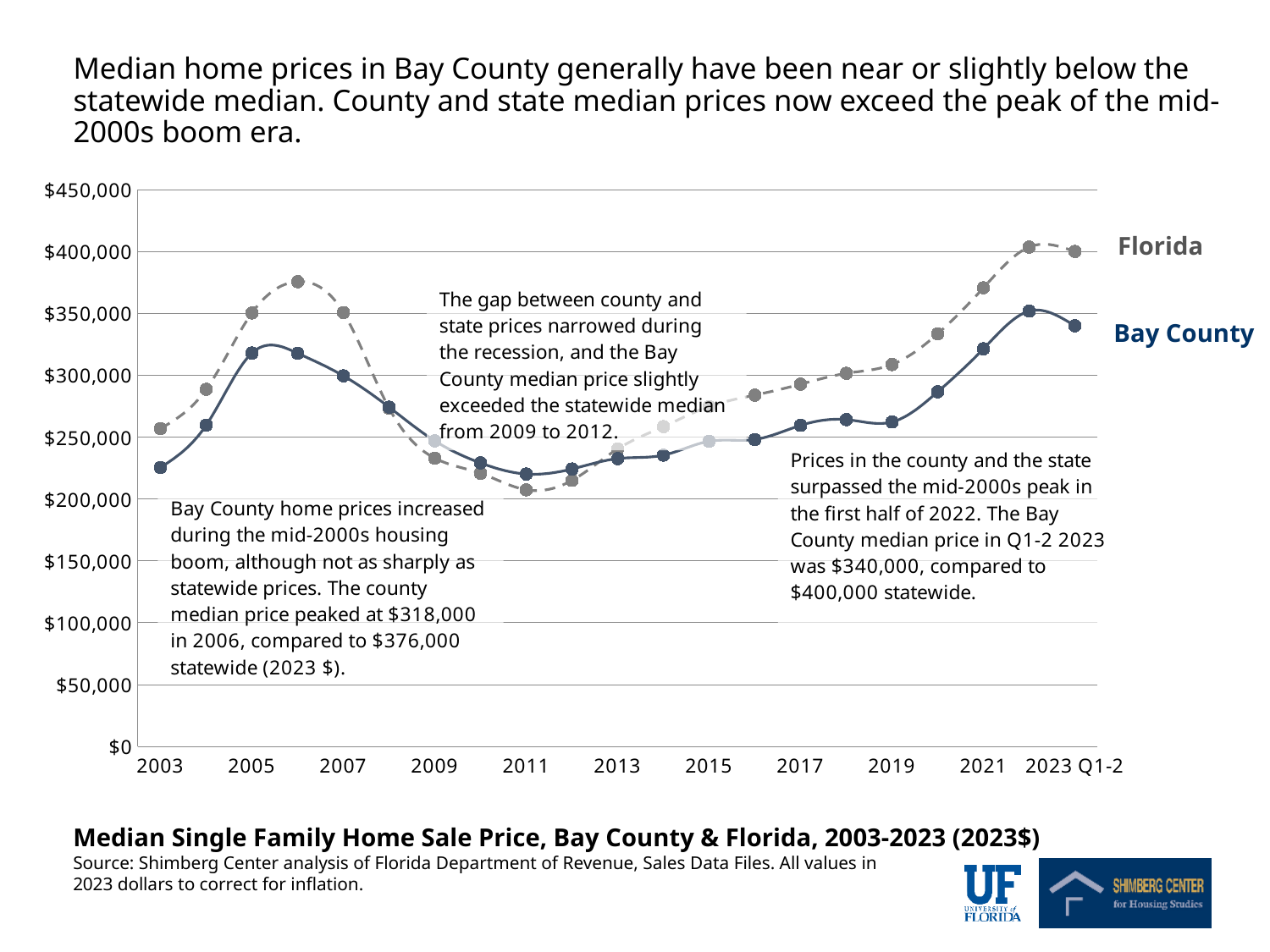
What was the statewide (Florida) median home price in 2006, according to the slide? $376,000 What kind of chart is shown on the slide? line chart What was the Bay County median price in Q1-2 2023? $340,000 What was the difference between the Florida and Bay County median prices in 2006? $58,000 Which series is drawn with a dashed grey line? Florida How much higher was the Florida median price than the Bay County median price in Q1-2 2023? $60,000 In 2006, which series had the higher median price, Florida or Bay County? Florida Did the Bay County median price rise or fall between 2019 and 2022? rise Is the Bay County value for 2003 greater or less than $250,000? less What was the Florida median price in Q1-2 2023? $400,000 How many series are plotted on the chart? 2 What was the Bay County median home price at its 2006 peak, according to the slide? $318,000